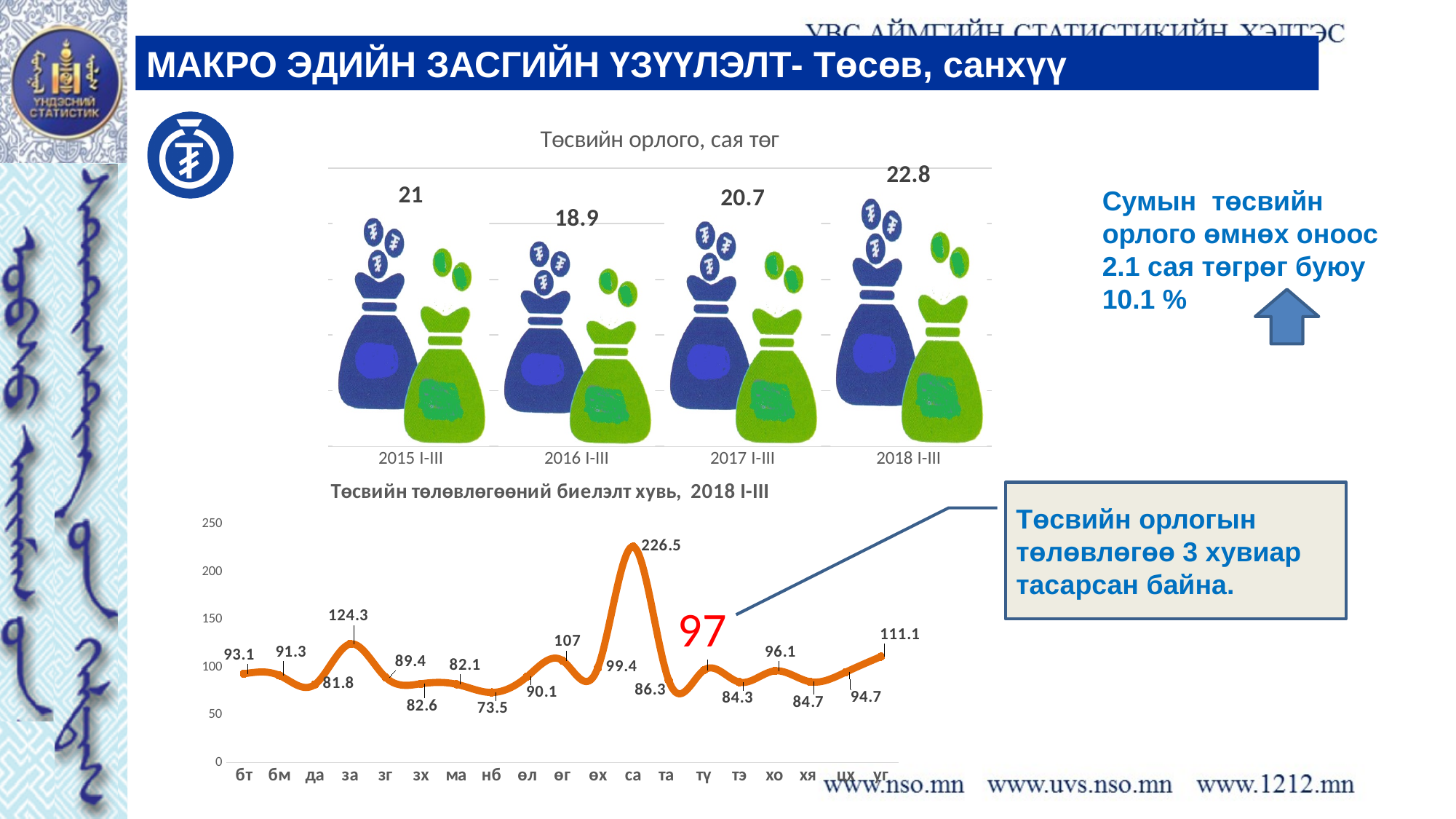
What kind of chart is the bottom chart 'Төсвийн төлөвлөгөөний биелэлт хувь, 2018 I-III'? line chart In the bottom chart 'Төсвийн төлөвлөгөөний биелэлт хувь, 2018 I-III', what is the value for нб? 73.5 In the bottom chart 'Төсвийн төлөвлөгөөний биелэлт хувь, 2018 I-III', which category has the highest value? са In the top chart 'Төсвийн орлого, сая төг', which period has the highest value? 2018 I-III In the top chart 'Төсвийн орлого, сая төг', what is the value for 2016 I-III? 18.9 In the top chart 'Төсвийн орлого, сая төг', what is the difference between the 2018 I-III and 2017 I-III values? 2.1 In the bottom chart 'Төсвийн төлөвлөгөөний биелэлт хувь, 2018 I-III', what is the value for са? 226.5 In the top chart 'Төсвийн орлого, сая төг', which period has the lowest value? 2016 I-III In the bottom chart 'Төсвийн төлөвлөгөөний биелэлт хувь, 2018 I-III', which category has the lowest value? нб In the top chart 'Төсвийн орлого, сая төг', what is the value for 2018 I-III? 22.8 In the top chart 'Төсвийн орлого, сая төг', how many periods are shown? 4